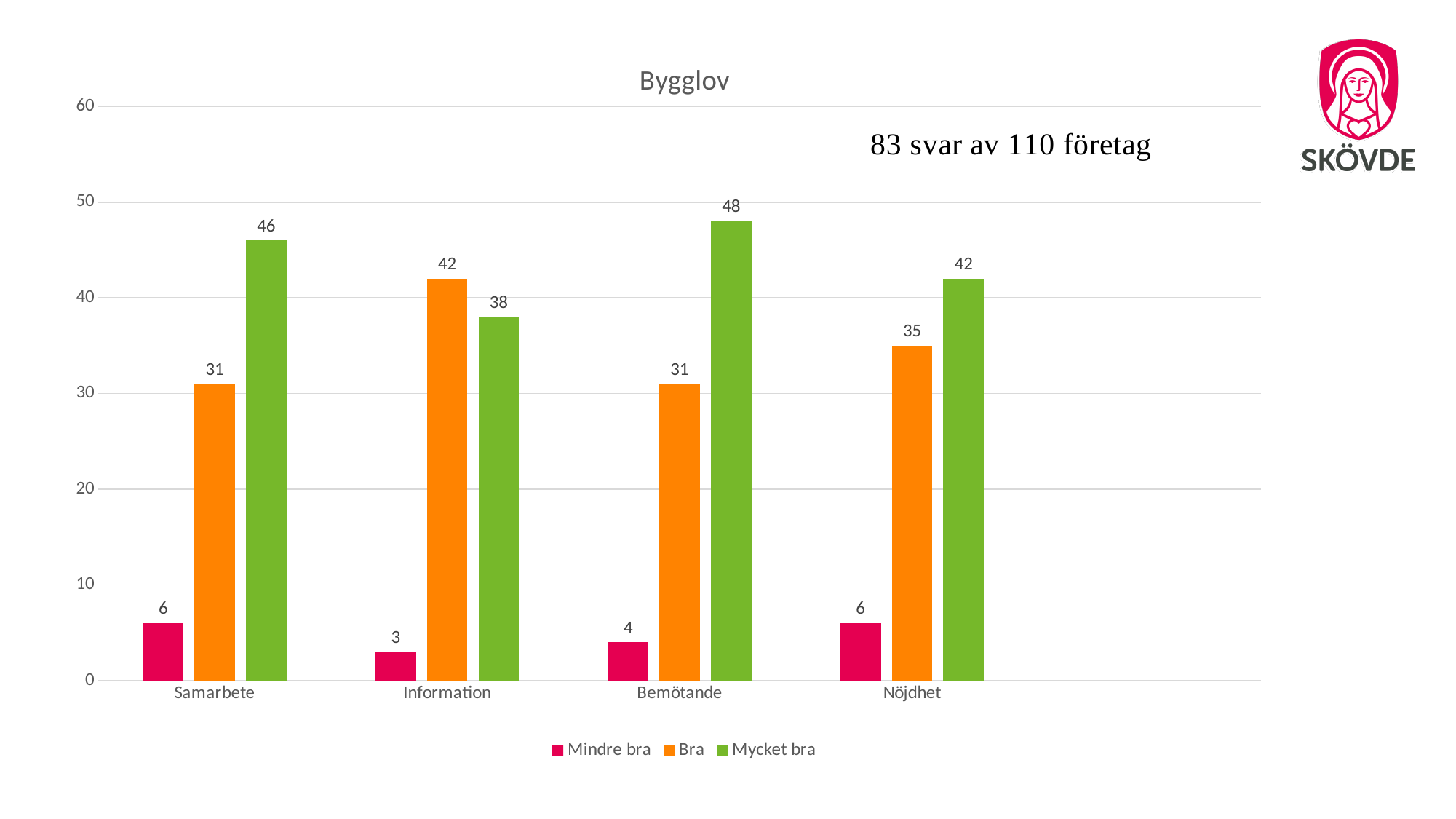
How many series does the legend list? 3 What is the value for Mindre bra in the Samarbete category? 6 What kind of chart is shown on the slide? Bar chart What is the value for Mycket bra in the Bemötande category? 48 What is the title of the chart? Bygglov Which category has the lowest value for Mindre bra? Information What is the difference between the Mycket bra and Bra values in the Nöjdhet category? 7 Which category has the highest value for Mycket bra? Bemötande In the Information category, which is larger: Bra or Mycket bra? Bra Is the value for Bra in the Nöjdhet category greater or less than 30? greater How many categories are shown on the x axis? 4 What is the value for Bra in the Information category? 42